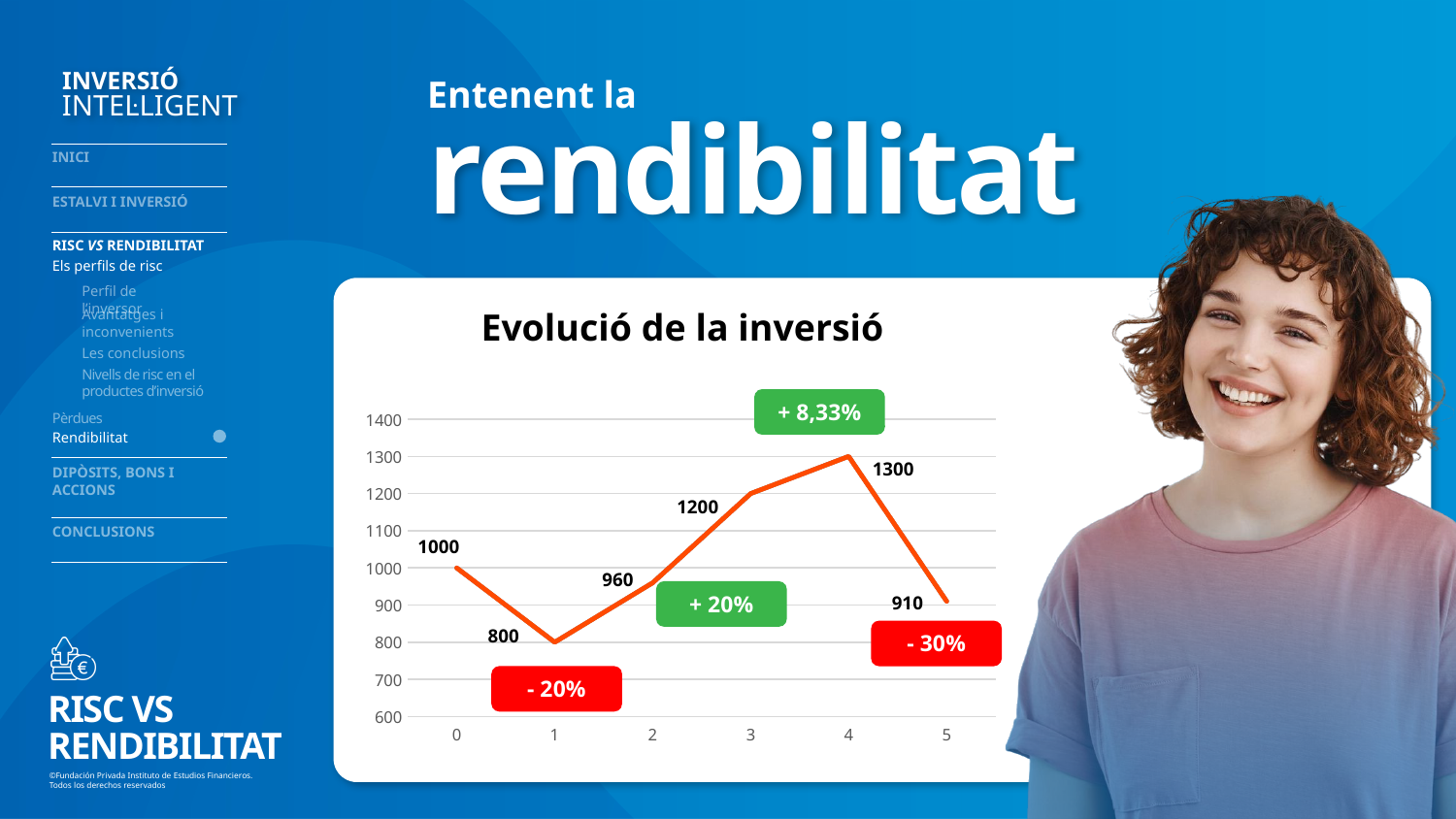
What is the value at x = 1? 800 What is the value at x = 5? 910 At which x value is the plotted value highest? 4 What is the value at x = 3? 1200 What kind of chart is shown on the slide? line chart What is the difference between the value at x = 4 and the value at x = 5? 390 At which x value is the plotted value lowest? 1 How many data points are plotted on the line? 6 Which is larger, the value at x = 2 or the value at x = 5? x = 2 What is the title of the chart? Evolució de la inversió What percentage change is shown in the green label between x = 3 and x = 4? + 8,33% What is the value at x = 0? 1000